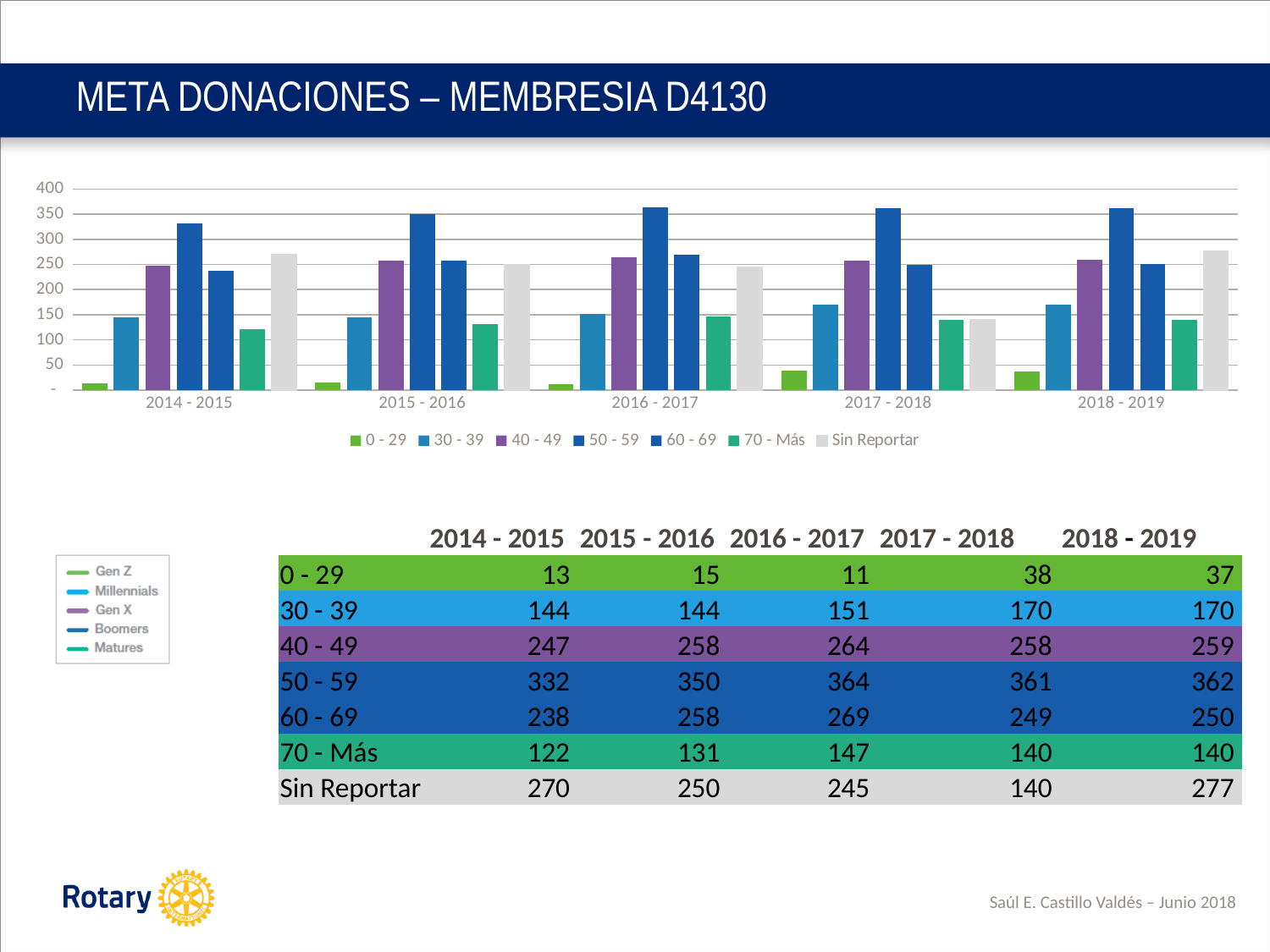
Is the value for 50 - 59 in 2017 - 2018 greater or less than 350? greater Which is larger in 2018 - 2019, the Sin Reportar value or the 40 - 49 value? Sin Reportar What kind of chart is shown on the slide? bar chart Which series has the lowest value in 2015 - 2016? 0 - 29 Which series has the highest value in 2014 - 2015? 50 - 59 Does the value for the 30 - 39 series rise or fall from 2014 - 2015 to 2018 - 2019? rise What is the value for the 50 - 59 series in 2016 - 2017? 364 What is the value for Sin Reportar in 2017 - 2018? 140 What is the difference between the 50 - 59 value and the 60 - 69 value in 2014 - 2015? 94 What is the value for the 0 - 29 series in 2018 - 2019? 37 How many series does the chart legend list? 7 How many year periods are shown along the x axis of the chart? 5